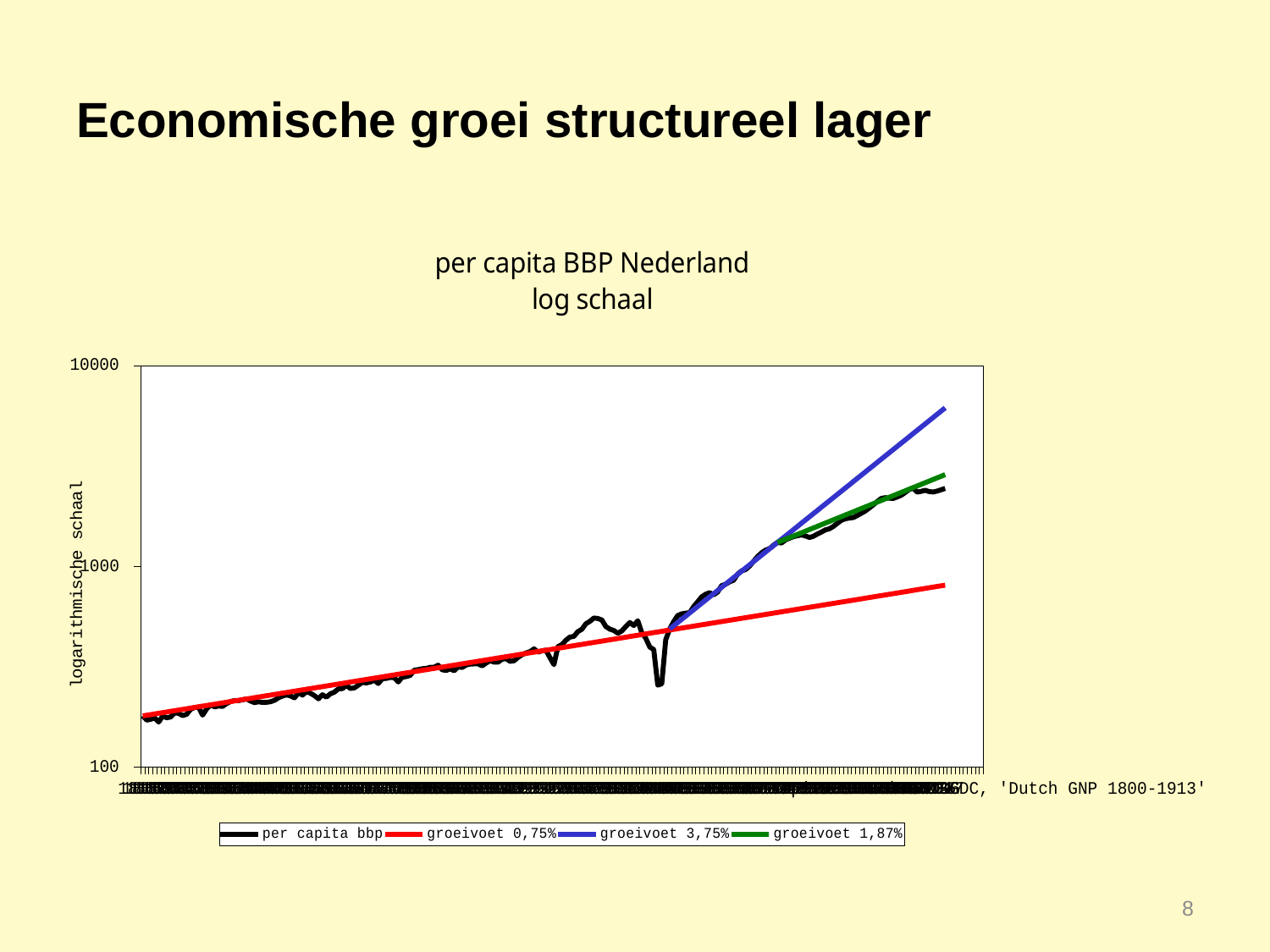
At the left edge of the chart, is the per capita bbp line greater or less than 1000? less Does the per capita bbp line generally rise or fall from left to right? rise At the right edge of the chart, is the groeivoet 0,75% line greater or less than 1000? less At the right edge of the chart, is the per capita bbp line greater or less than 1000? greater Which series reaches the highest value at the right edge of the chart? groeivoet 3,75% What is the highest tick value shown on the vertical axis? 10000 How many series does the legend list? 4 Which series is lowest at the right edge of the chart? groeivoet 0,75% What kind of chart is shown on the slide? line chart What is the title of the chart? per capita BBP Nederland log schaal What is the label on the vertical axis? logarithmische schaal At the right edge of the chart, which is higher: the groeivoet 3,75% line or the groeivoet 1,87% line? groeivoet 3,75%